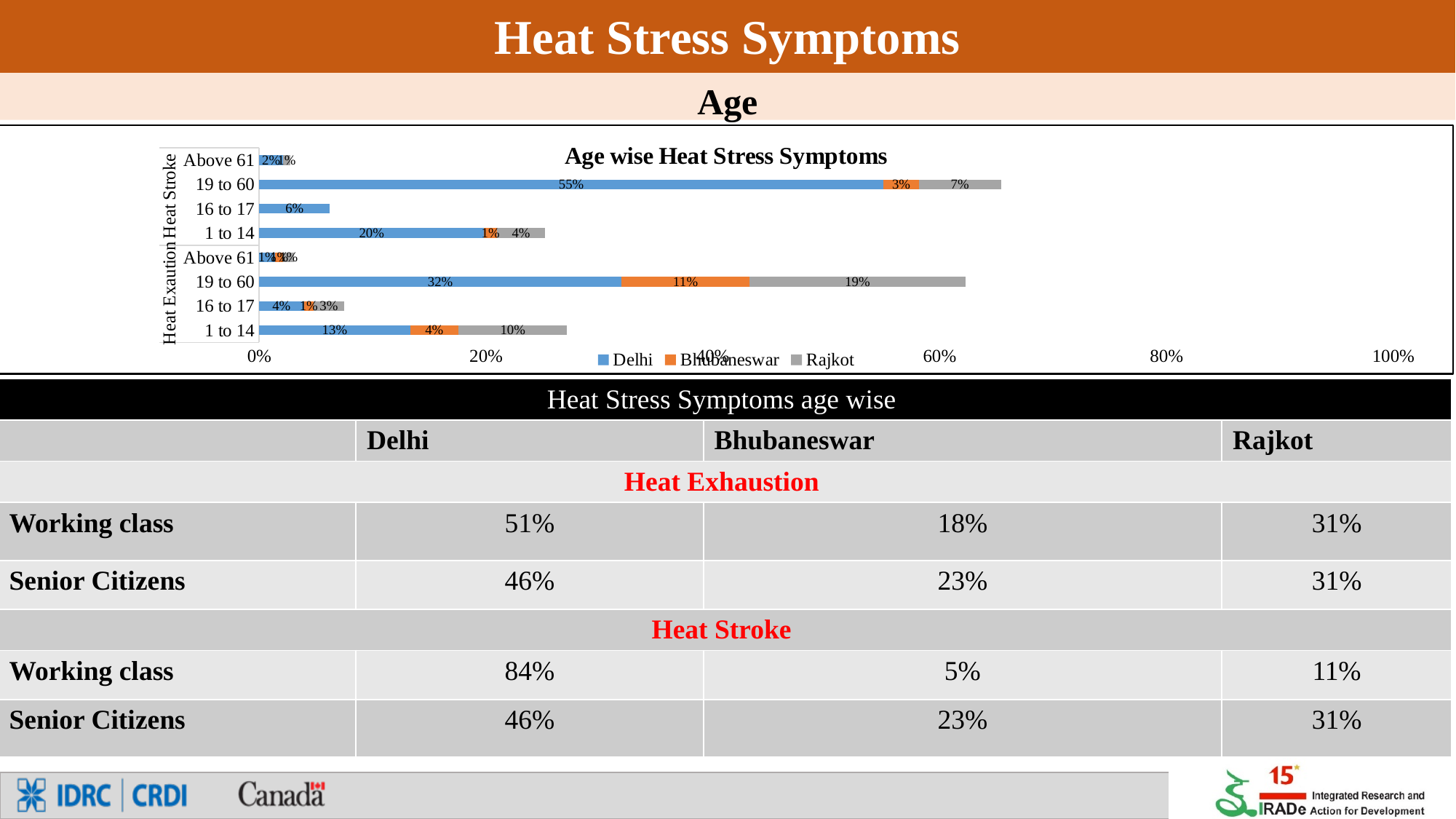
What is the total of the stacked bar for the 1 to 14 age group under Heat Stroke? 25% What is the Rajkot value for the 19 to 60 age group under Heat Exaution? 19% What is the total of the stacked bar for the 19 to 60 age group under Heat Exaution? 62% What is the Delhi value for the 19 to 60 age group under Heat Stroke? 55% What is the difference between the Delhi values for the 19 to 60 age group under Heat Stroke and under Heat Exaution? 23% Is the Delhi value for the 19 to 60 age group under Heat Exaution greater or less than 20%? greater What is the Bhubaneswar value for the 1 to 14 age group under Heat Exaution? 4% What is the title of the chart? Age wise Heat Stress Symptoms How many series does the chart legend list? 3 Which age group has the longest stacked bar under Heat Stroke? 19 to 60 What type of chart is shown on the slide? Stacked bar chart What is the Delhi value for the 16 to 17 age group under Heat Stroke? 6%